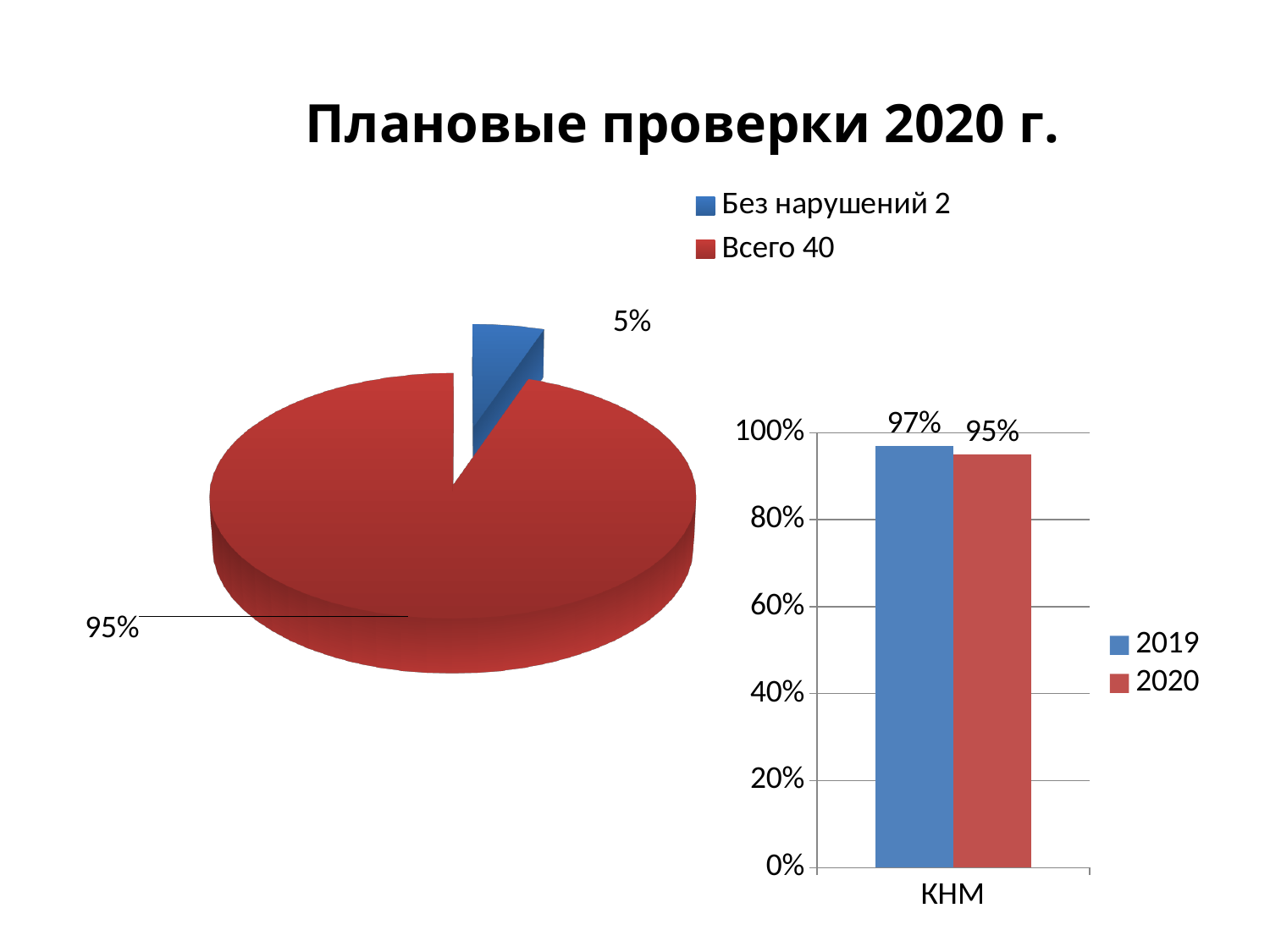
On the pie chart on the left, which slice is the largest? Всего 40 On the pie chart on the left, what share is labelled for the 'Всего 40' slice? 95% On the bar chart on the right, which series has the higher value for КНМ, 2019 or 2020? 2019 On the bar chart on the right, what is the value for 2020 in the КНМ category? 95% On the pie chart on the left, how many slices are there? 2 What kind of chart is the chart on the left of the slide? Pie chart On the bar chart on the right, what is the value for 2019 in the КНМ category? 97% On the bar chart on the right, how many series does the legend list? 2 On the pie chart on the left, what share is labelled for the 'Без нарушений 2' slice? 5% What is the title of the slide? Плановые проверки 2020 г. On the bar chart on the right, what is the difference between the 2019 and 2020 values for КНМ? 2% On the pie chart on the left, which slice is the smallest? Без нарушений 2